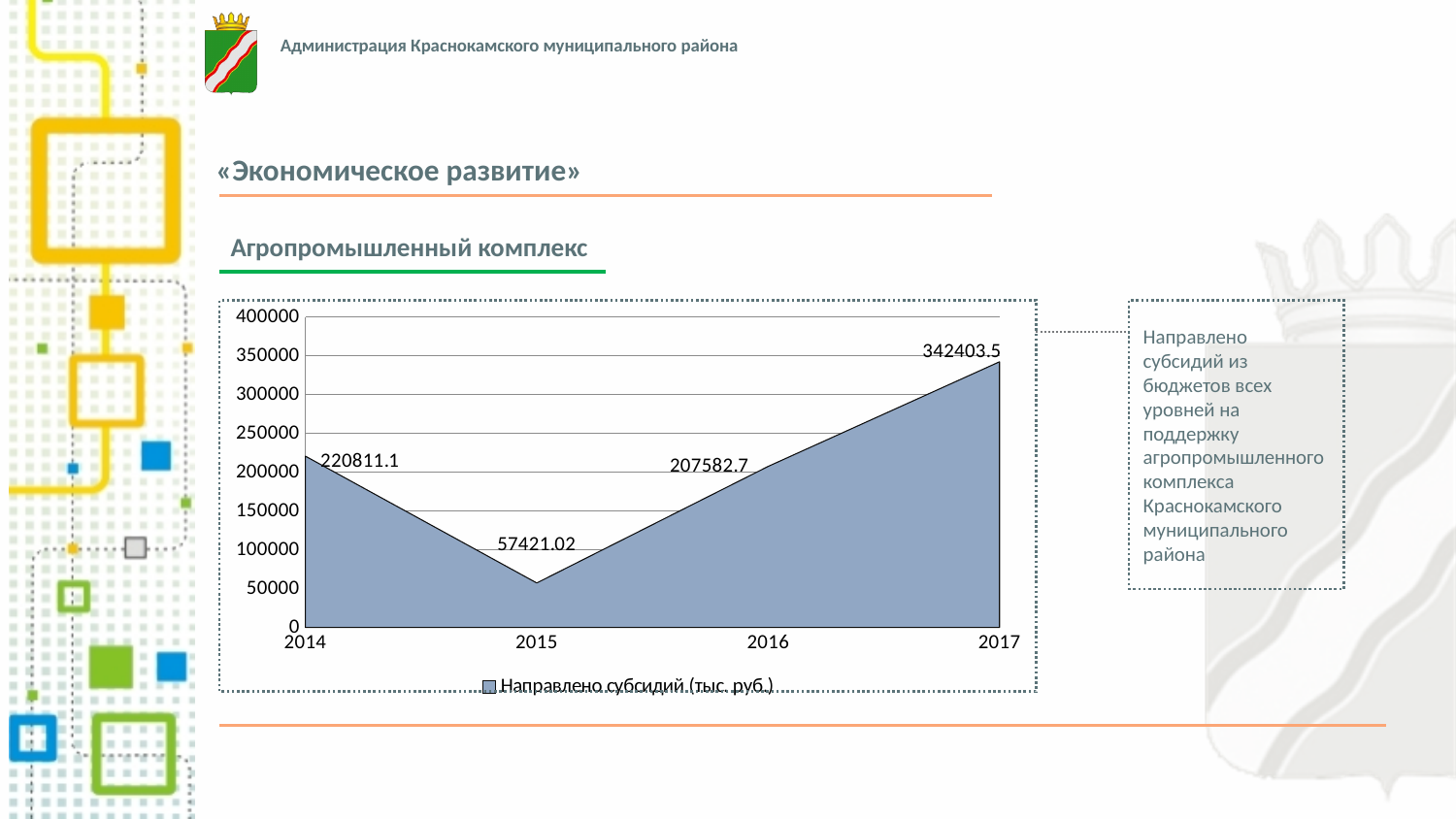
Which year has the highest value? 2017 What is the value for 2017? 342403.5 What is the value for 2015? 57421.02 What is the value for 2016? 207582.7 What type of chart is shown? area chart Which is larger, the value for 2014 or the value for 2016? 2014 Which year has the lowest value? 2015 What is the difference between the values for 2017 and 2016? 134820.8 How many years are shown on the x axis? 4 Is the value for 2015 greater or less than 100000? less What is the legend entry of the chart? Направлено субсидий (тыс. руб.) What is the value for 2014? 220811.1